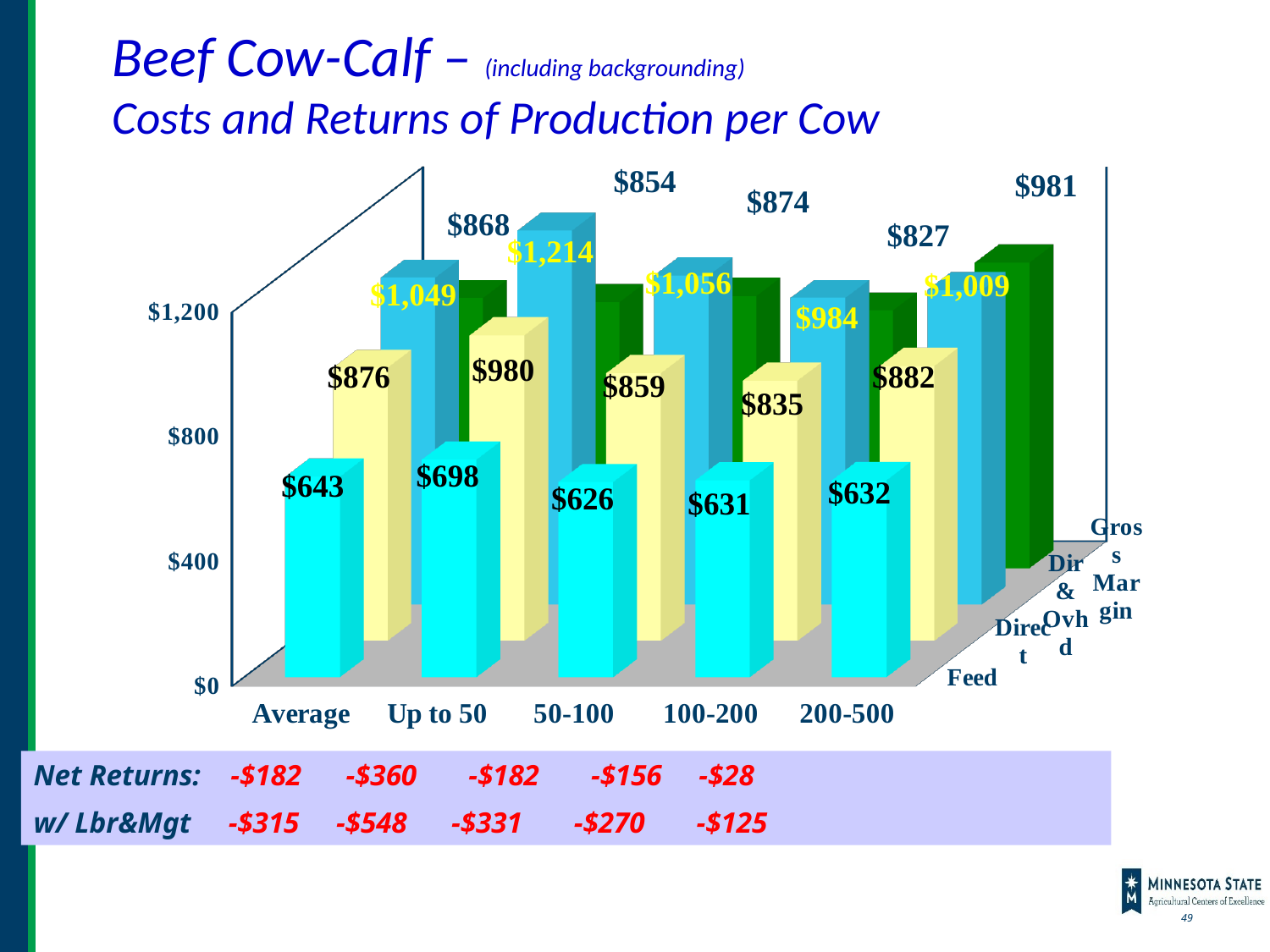
How many herd-size categories are shown on the x axis? 5 What is the Direct value for the Up to 50 category? $980 What is the difference between the Gross Margin values for 200-500 and 100-200? $154 What is the Dir & Ovhd value for the Up to 50 category? $1,214 What is the Gross Margin value for the 200-500 category? $981 Which category has the highest Feed value? Up to 50 How many series does the chart show? 4 How much higher is the Direct value for Up to 50 than for Average? $104 Which is larger, the Feed value for 50-100 or for 100-200? 100-200 Which category has the lowest Direct value? 100-200 What is the Feed value for the Average category? $643 What kind of chart is shown on the slide? bar chart